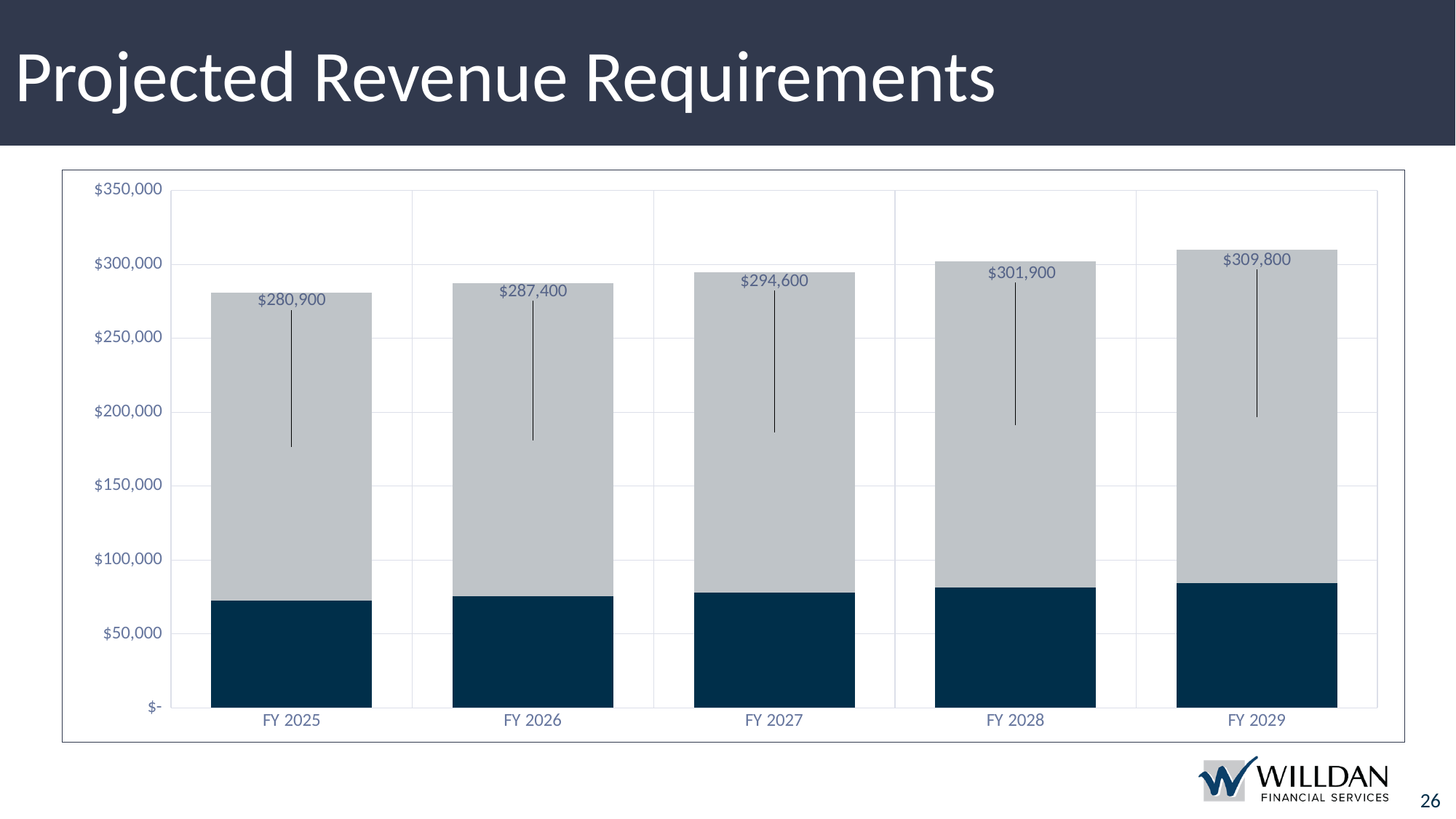
Is the dark blue segment for FY 2025 greater or less than $100,000? less What is the difference between the total for FY 2028 and the total for FY 2027? $7,300 What is the total projected revenue requirement labeled for FY 2027? $294,600 Which fiscal year has the highest total projected revenue requirement? FY 2029 Which fiscal year has the lowest total projected revenue requirement? FY 2025 Do the total projected revenue requirements rise or fall from FY 2025 to FY 2029? Rise Which is larger, the total for FY 2026 or the total for FY 2028? FY 2028 What type of chart is shown on the slide? Stacked bar chart What is the difference between the total for FY 2029 and the total for FY 2025? $28,900 How many fiscal years are shown on the x axis? 5 What is the total projected revenue requirement labeled for FY 2029? $309,800 What is the total projected revenue requirement labeled for FY 2025? $280,900